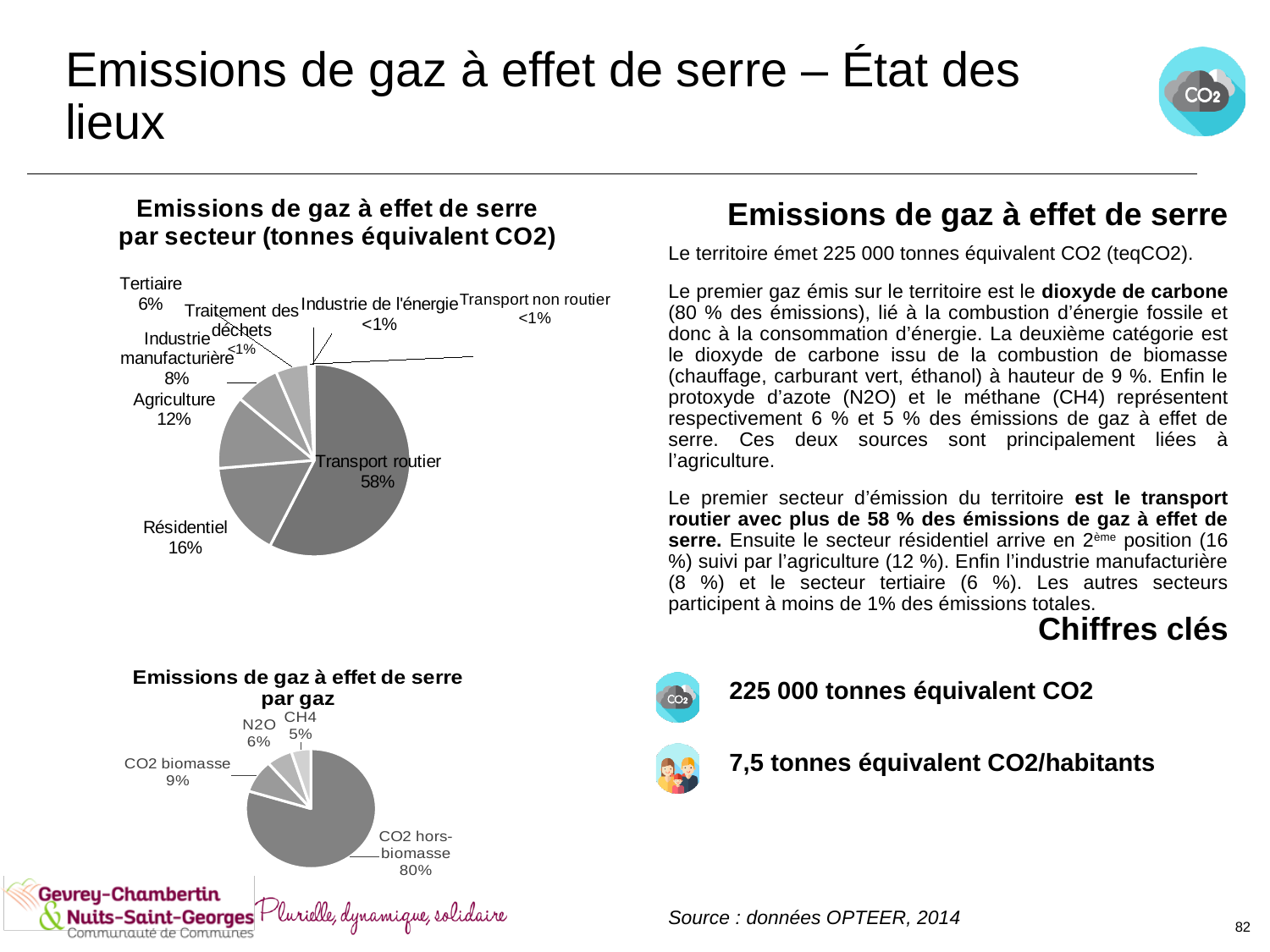
In the chart 'Emissions de gaz à effet de serre par secteur', what is the difference between Résidentiel and Agriculture? 4% In the chart 'Emissions de gaz à effet de serre par secteur', which sector has the largest share? Transport routier How many sectors are shown in the chart 'Emissions de gaz à effet de serre par secteur'? 8 What type of chart is 'Emissions de gaz à effet de serre par secteur'? Pie chart In the chart 'Emissions de gaz à effet de serre par gaz', what is the value for CO2 biomasse? 9% In the chart 'Emissions de gaz à effet de serre par secteur', what is the value for Résidentiel? 16% In the chart 'Emissions de gaz à effet de serre par secteur', what is the value for Agriculture? 12% In the chart 'Emissions de gaz à effet de serre par secteur', what share does Transport routier have? 58% How many gases are shown in the chart 'Emissions de gaz à effet de serre par gaz'? 4 In the chart 'Emissions de gaz à effet de serre par gaz', which gas has the smallest share? CH4 In the chart 'Emissions de gaz à effet de serre par secteur', which is larger, Industrie manufacturière or Tertiaire? Industrie manufacturière In the chart 'Emissions de gaz à effet de serre par gaz', what share does CO2 hors-biomasse have? 80%